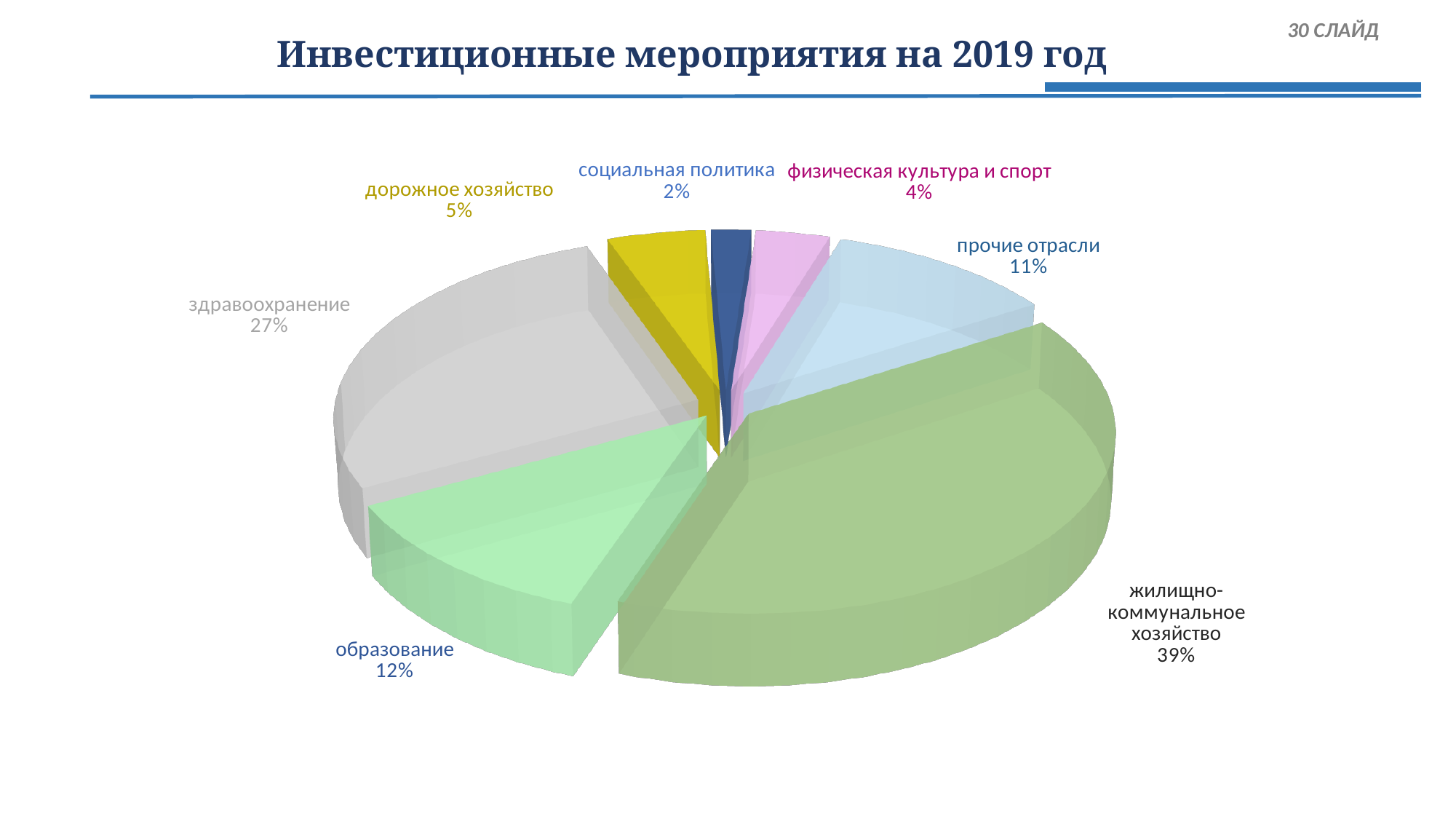
What kind of chart is shown on the slide? pie chart What is the difference between the shares of здравоохранение and образование? 15% What is the title of the chart on the slide? Инвестиционные мероприятия на 2019 год What is the value shown for социальная политика? 2% What share of the pie does жилищно-коммунальное хозяйство have? 39% How many categories are shown in the pie chart? 7 What share of the pie does здравоохранение have? 27% What is the value shown for образование? 12% What is the value shown for прочие отрасли? 11% Which category has the smallest slice of the pie? социальная политика Which category has the largest slice of the pie? жилищно-коммунальное хозяйство Which is larger, the share of дорожное хозяйство or the share of физическая культура и спорт? дорожное хозяйство